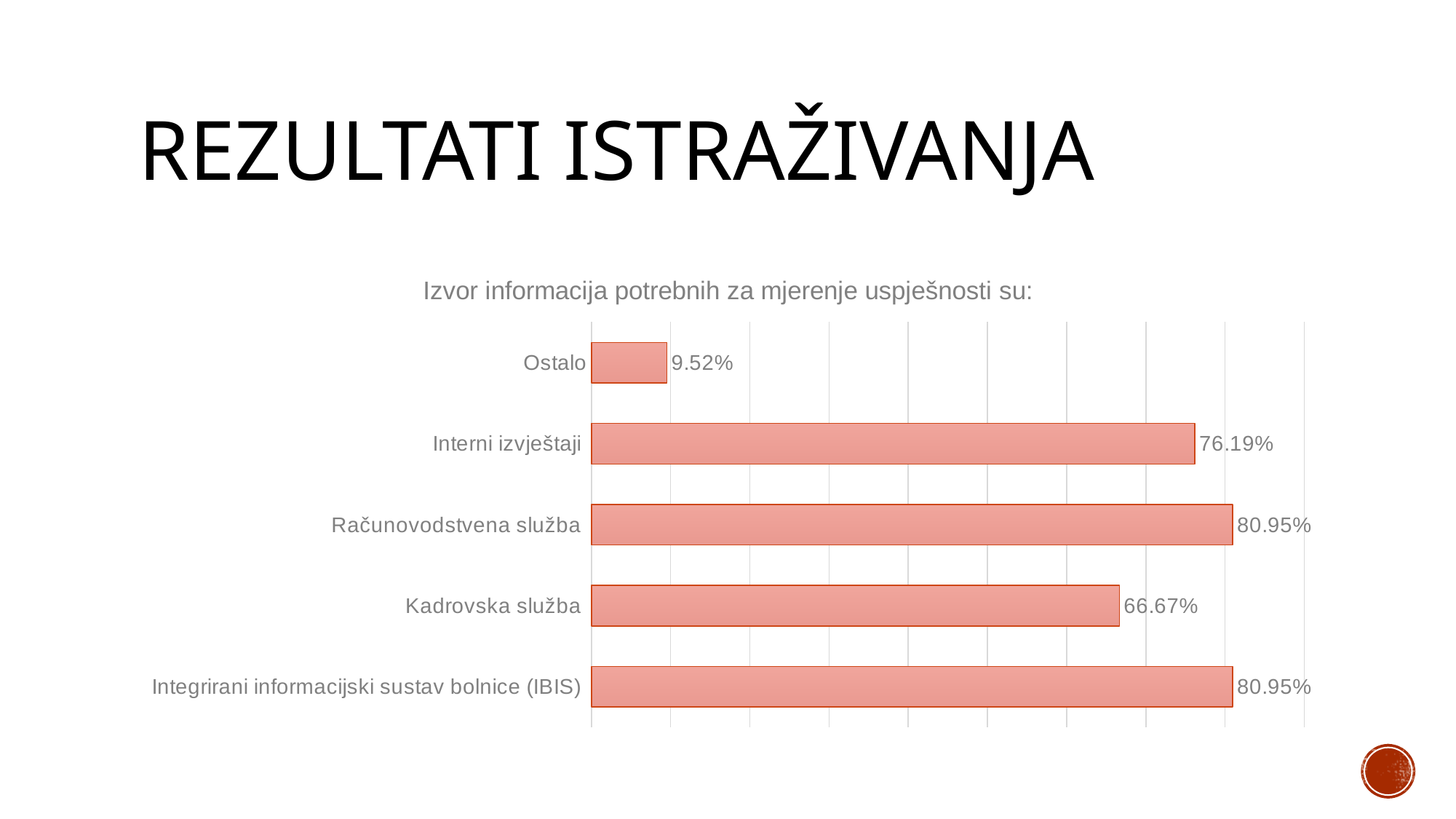
What is the value for Računovodstvena služba? 80.95% What is the title of the chart? Izvor informacija potrebnih za mjerenje uspješnosti su: What is the value for Ostalo? 9.52% How many categories are shown in the chart? 5 What kind of chart is shown on the slide? Bar chart What is the value for Interni izvještaji? 76.19% What is the value for Integrirani informacijski sustav bolnice (IBIS)? 80.95% Which category has the lowest value? Ostalo What is the difference between the values for Interni izvještaji and Kadrovska služba? 9.52% Which is larger, the value for Interni izvještaji or the value for Kadrovska služba? Interni izvještaji What is the value for Kadrovska služba? 66.67% What is the difference between the values for Računovodstvena služba and Ostalo? 71.43%